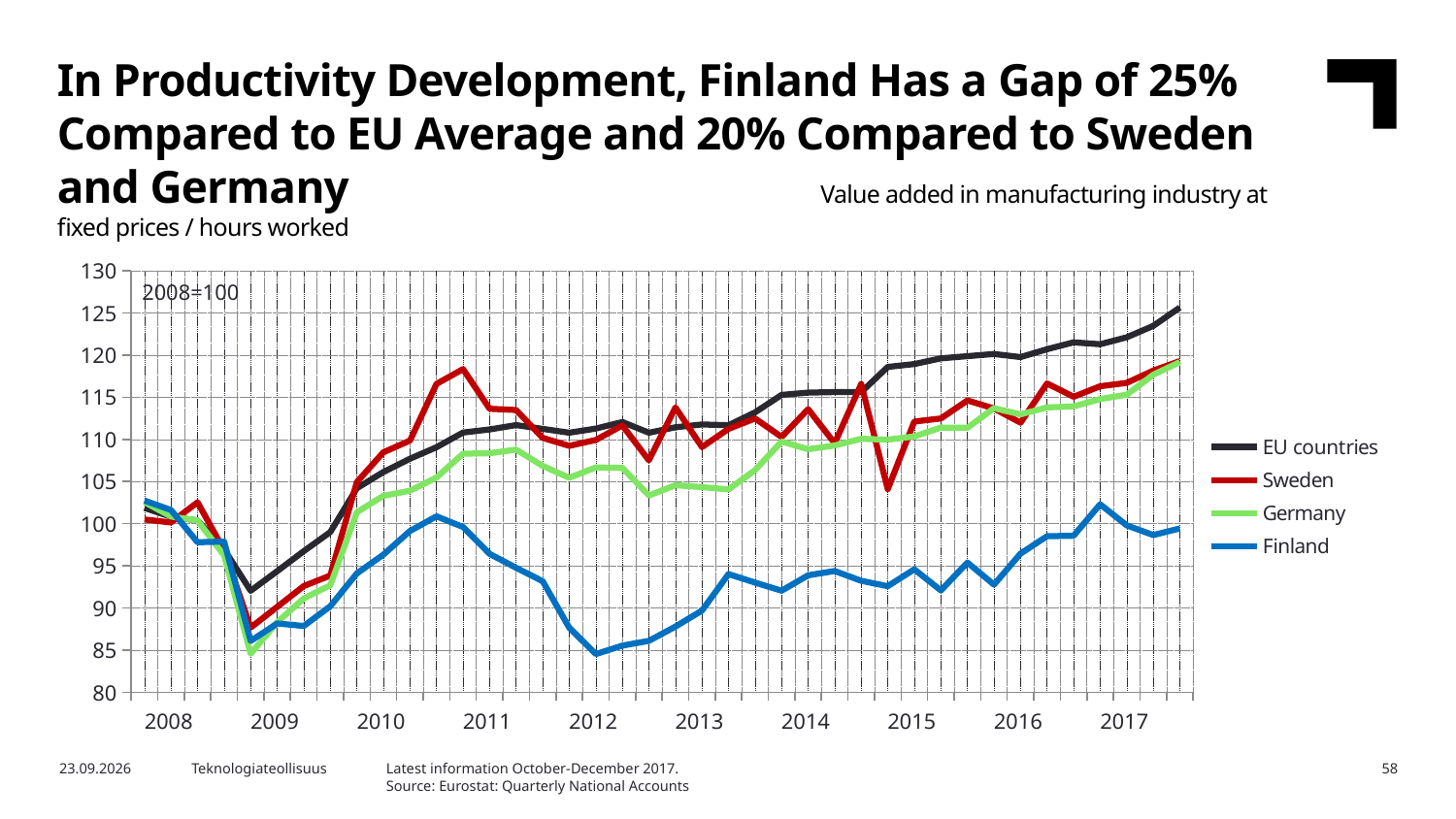
Does the EU countries line rise or fall from 2010 to 2017? Rises Is the value for Finland at the end of 2017 greater or less than 105? less What type of chart is shown on the slide? Line chart How many series does the legend list? 4 Is the value for EU countries at the end of 2017 greater or less than 120? greater Which series has the lowest value at the end of 2017? Finland Which series has the highest value at the end of 2017? EU countries Which is larger at the end of 2017, the value for Germany or the value for Finland? Germany How many years are labelled on the x axis? 10 Which series dips lowest in 2009? Germany Is the lowest value for Finland in 2012 greater or less than 90? less What base year index is noted in the top-left corner of the chart? 2008=100